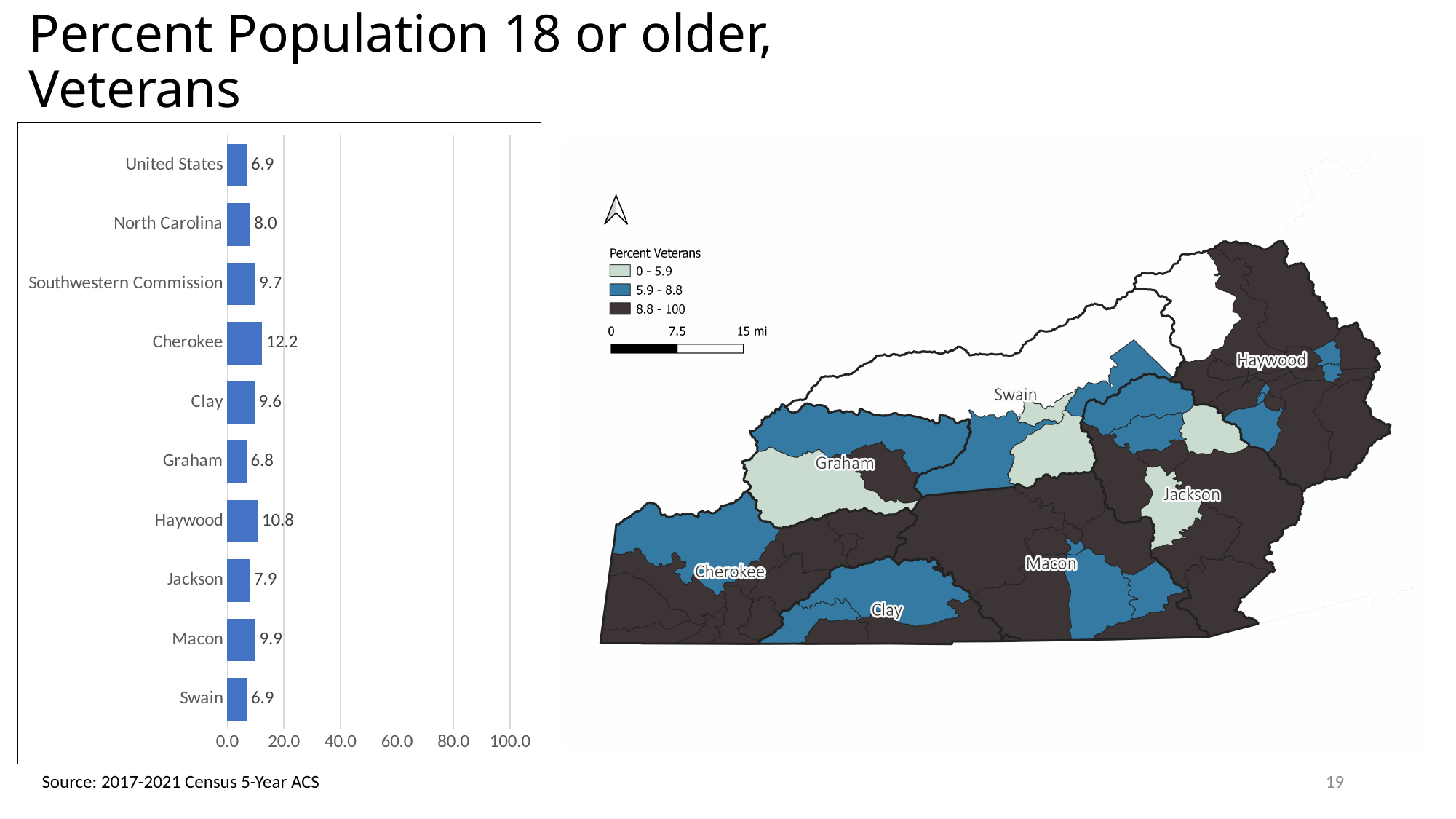
What is the value for Cherokee in the bar chart? 12.2 What is the value for Haywood in the bar chart? 10.8 What is the difference between the values for Haywood and Jackson in the bar chart? 2.9 What is the value for North Carolina in the bar chart? 8.0 In the bar chart, is the value for Cherokee greater or less than 20.0? less How many categories are shown in the bar chart? 10 Which category has the lowest value in the bar chart? Graham What kind of chart is shown on the left of the slide? bar chart Which category has the highest value in the bar chart? Cherokee How many value ranges does the map legend for Percent Veterans list? 3 What is the difference between the values for Cherokee and Graham in the bar chart? 5.4 In the bar chart, which is larger, the value for Macon or the value for Clay? Macon